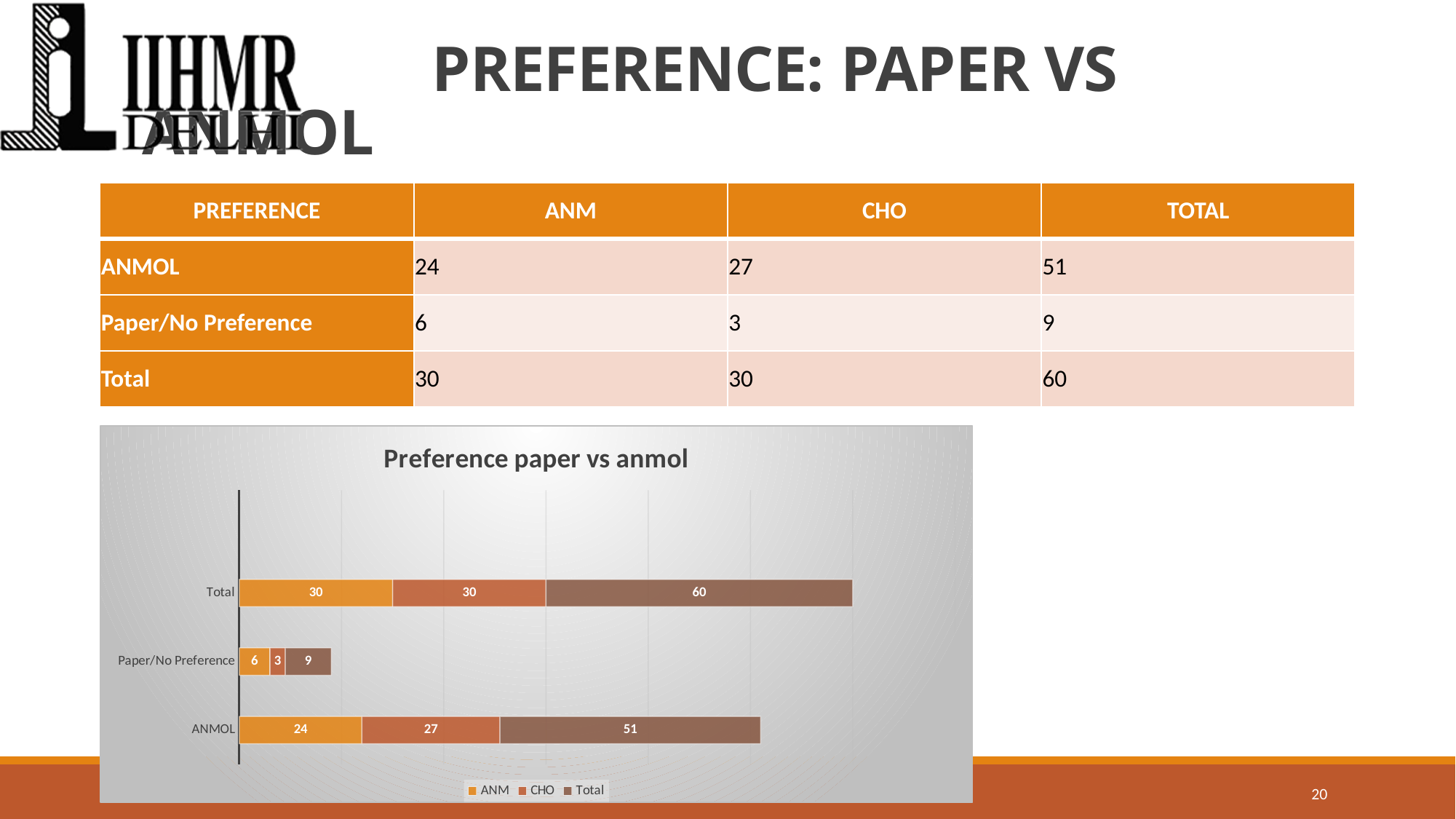
Which is larger in the chart: the ANM value for ANMOL or the ANM value for Paper/No Preference? ANM value for ANMOL What is the ANM value for ANMOL in the chart? 24 What is the difference between the CHO value and the ANM value for ANMOL in the chart? 3 Which category has the highest CHO value in the chart? Total How many series does the chart legend list? 3 Which category has the lowest ANM value in the chart? Paper/No Preference What is the Total series value for the Total category in the chart? 60 How many categories are plotted on the chart? 3 What is the total of the stacked bar for Paper/No Preference in the chart? 18 What is the title of the chart? Preference paper vs anmol What is the CHO value for Paper/No Preference in the chart? 3 What type of chart is shown on the slide? bar chart